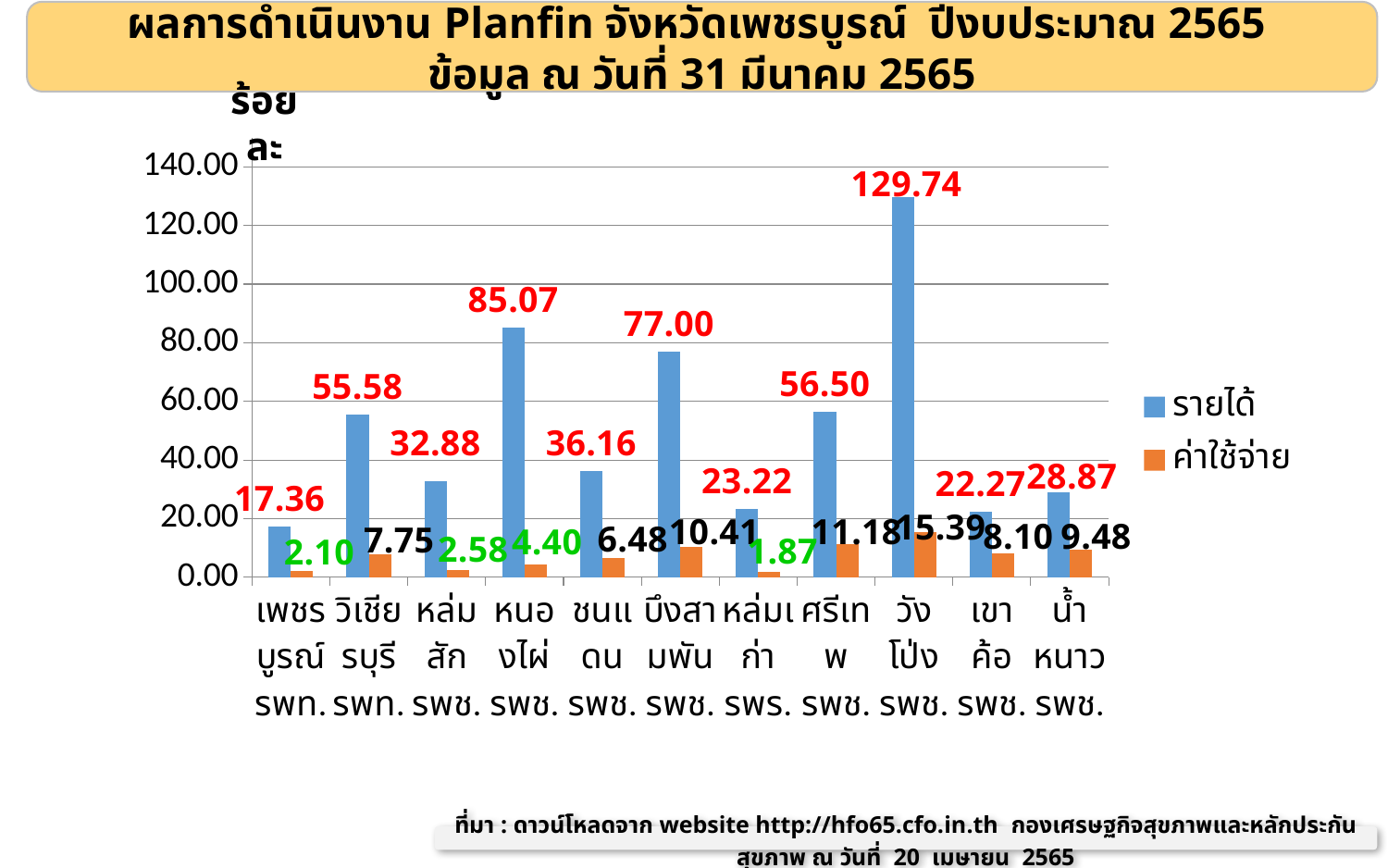
Which series is shown in orange? ค่าใช้จ่าย What is the ค่าใช้จ่าย value for บึงสามพัน รพช.? 10.41 What kind of chart is shown on the slide? bar chart Which category has the highest รายได้ value? วังโป่ง รพช. How many categories are shown on the x axis? 11 Is the รายได้ value for บึงสามพัน รพช. greater or less than 60.00? greater What is the รายได้ value for หนองไผ่ รพช.? 85.07 Which is larger, the รายได้ value for วิเชียรบุรี รพท. or for ศรีเทพ รพช.? ศรีเทพ รพช. What is the difference between the รายได้ values for วังโป่ง รพช. and หนองไผ่ รพช.? 44.67 Which category has the lowest ค่าใช้จ่าย value? หล่มเก่า รพร. How many series does the legend list? 2 What is the รายได้ value for วังโป่ง รพช.? 129.74